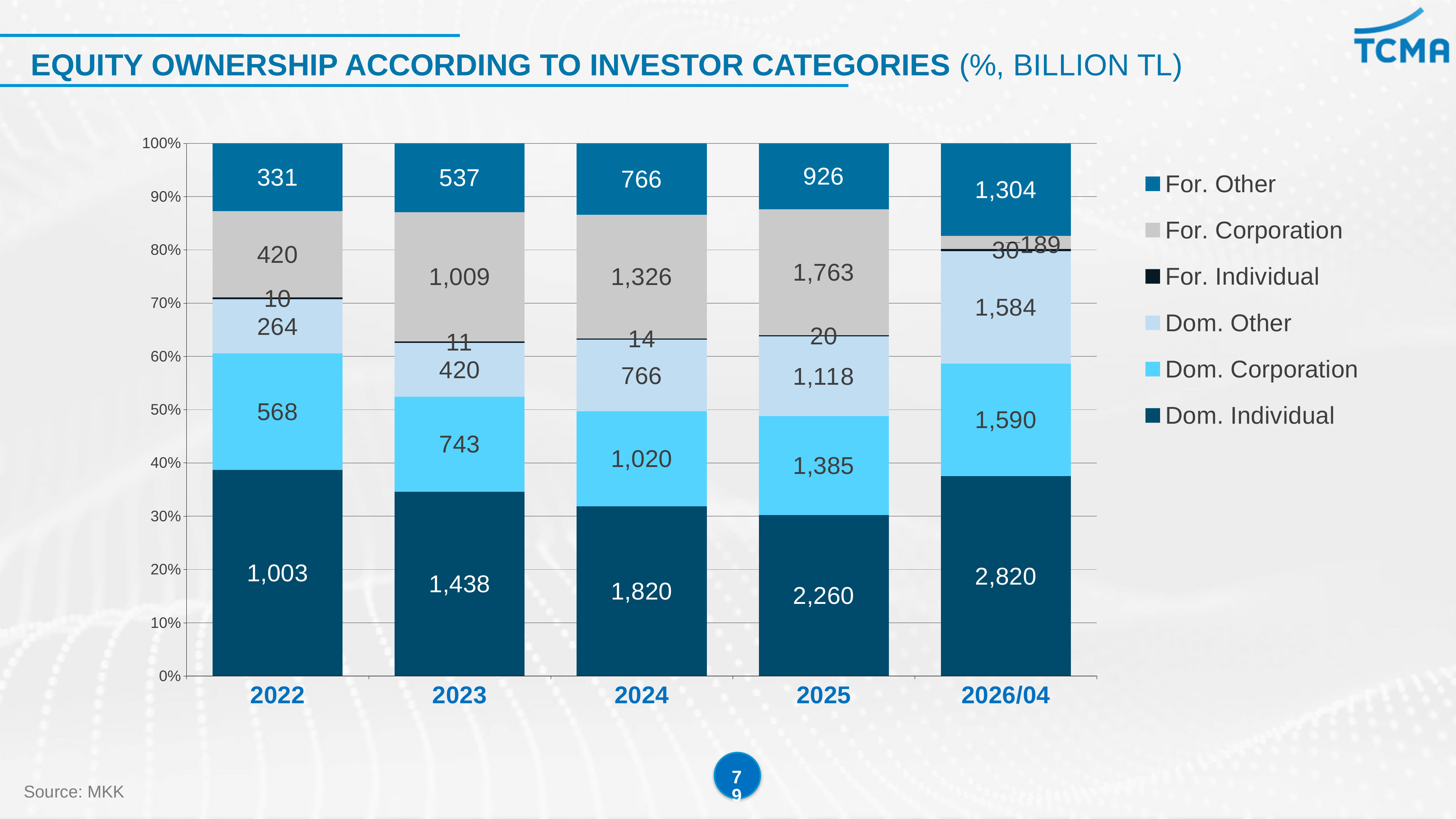
Which series is listed first (at the top) in the legend? For. Other What is the value for Dom. Individual in 2025? 2,260 What is the value for For. Corporation in 2023? 1,009 What is the total of all segments in the 2022 bar? 2,596 What is the difference between the Dom. Individual values in 2024 and 2023? 382 What is the value for For. Other in 2026/04? 1,304 How many periods are shown on the x axis? 5 What kind of chart is shown on the slide? Stacked bar chart How many series does the legend list? 6 In 2025, which is larger: For. Other or Dom. Other? Dom. Other Do the Dom. Individual values rise or fall from 2022 to 2026/04? Rise In which period is the Dom. Individual value highest? 2026/04